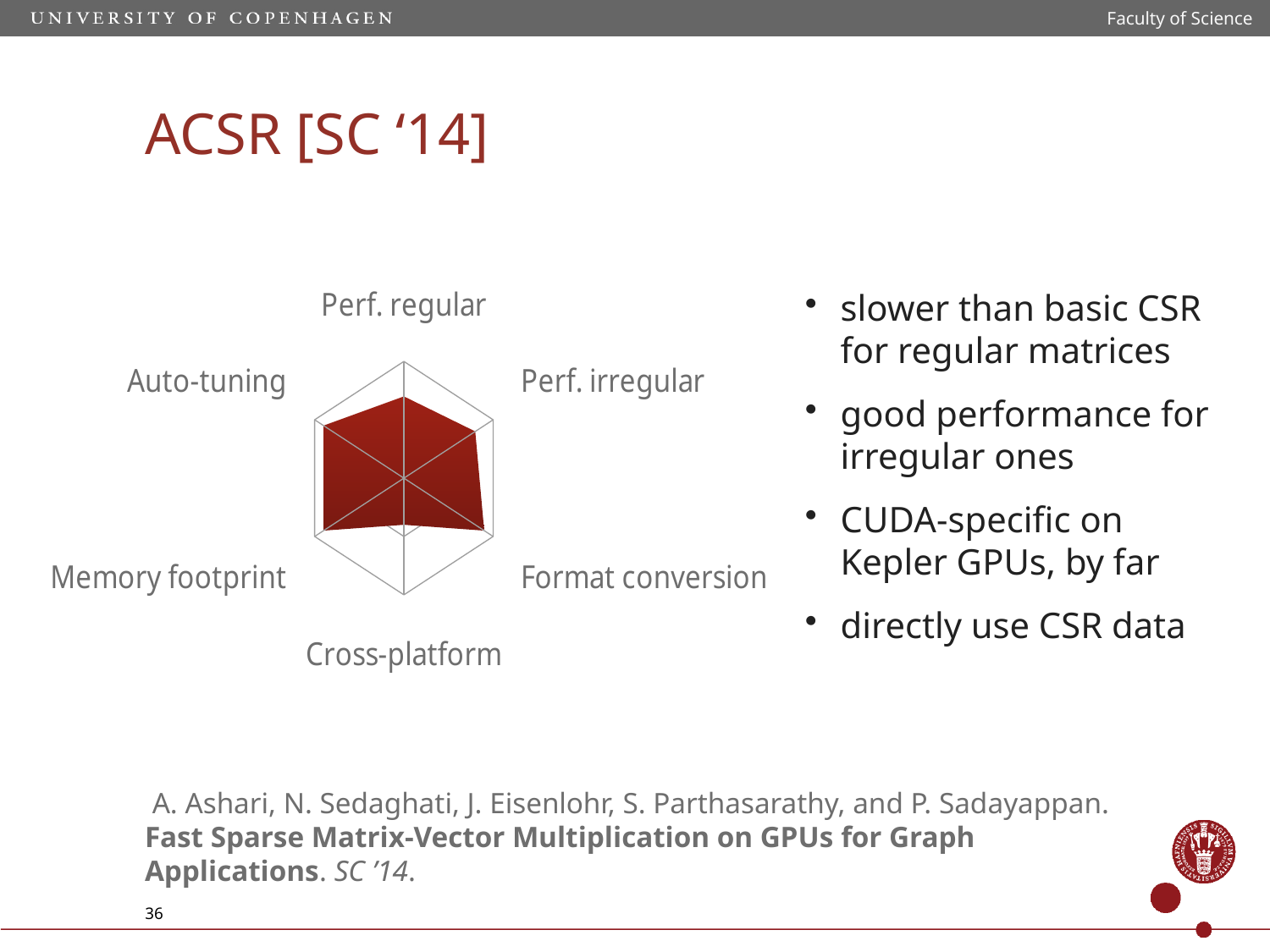
Which is larger on the radar chart, the value for Perf. irregular or the value for Perf. regular? Perf. irregular Which is larger on the radar chart, the value for Auto-tuning or the value for Cross-platform? Auto-tuning Which is larger on the radar chart, the value for Memory footprint or the value for Perf. regular? Memory footprint What kind of chart is shown on the slide? radar chart What colour is the filled area of the radar chart? dark red How many axes (categories) does the radar chart have? 6 Which category label appears at the top of the radar chart? Perf. regular